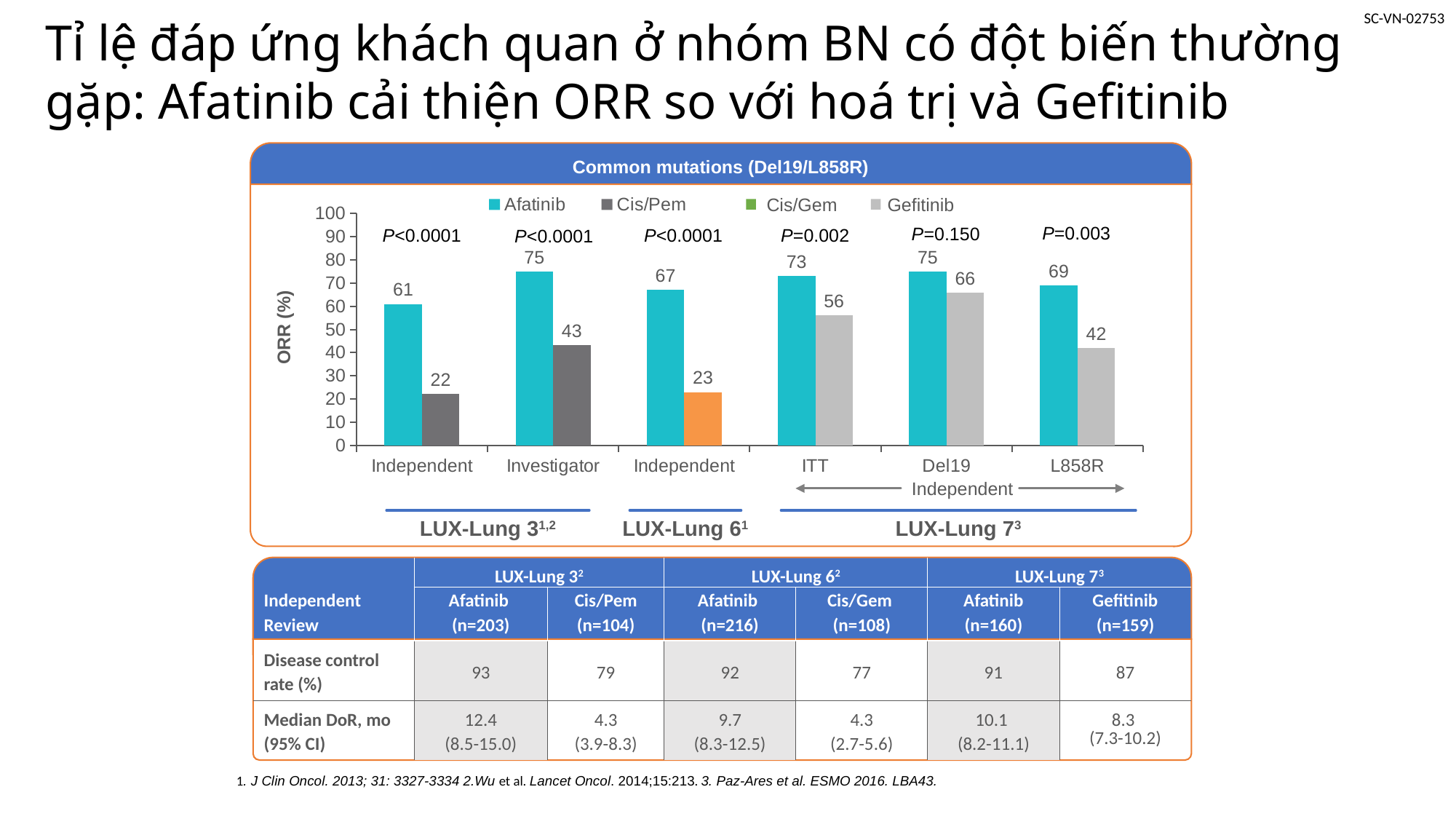
What type of chart is shown on the slide? Bar chart What is the ORR (%) for Cis/Pem in the Investigator assessment of LUX-Lung 3? 43 What is the ORR (%) for Cis/Gem in the Independent assessment of LUX-Lung 6? 23 How many category groups are shown along the x axis of the chart? 6 How many series does the chart legend list? 4 What is the ORR (%) for Gefitinib in the L858R group of LUX-Lung 7? 42 What is the ORR (%) for Afatinib in the ITT group of LUX-Lung 7? 73 Which group has the lowest ORR value shown on the chart? Cis/Pem, Independent (LUX-Lung 3) Which is larger: the Afatinib ORR in the ITT group or the Afatinib ORR in the L858R group? ITT What is the difference in ORR (%) between Afatinib and Cis/Pem in the Independent assessment of LUX-Lung 3? 39 What is the P value shown above the Del19 group? P=0.150 What is the difference in ORR (%) between Afatinib and Gefitinib in the Del19 group of LUX-Lung 7? 9